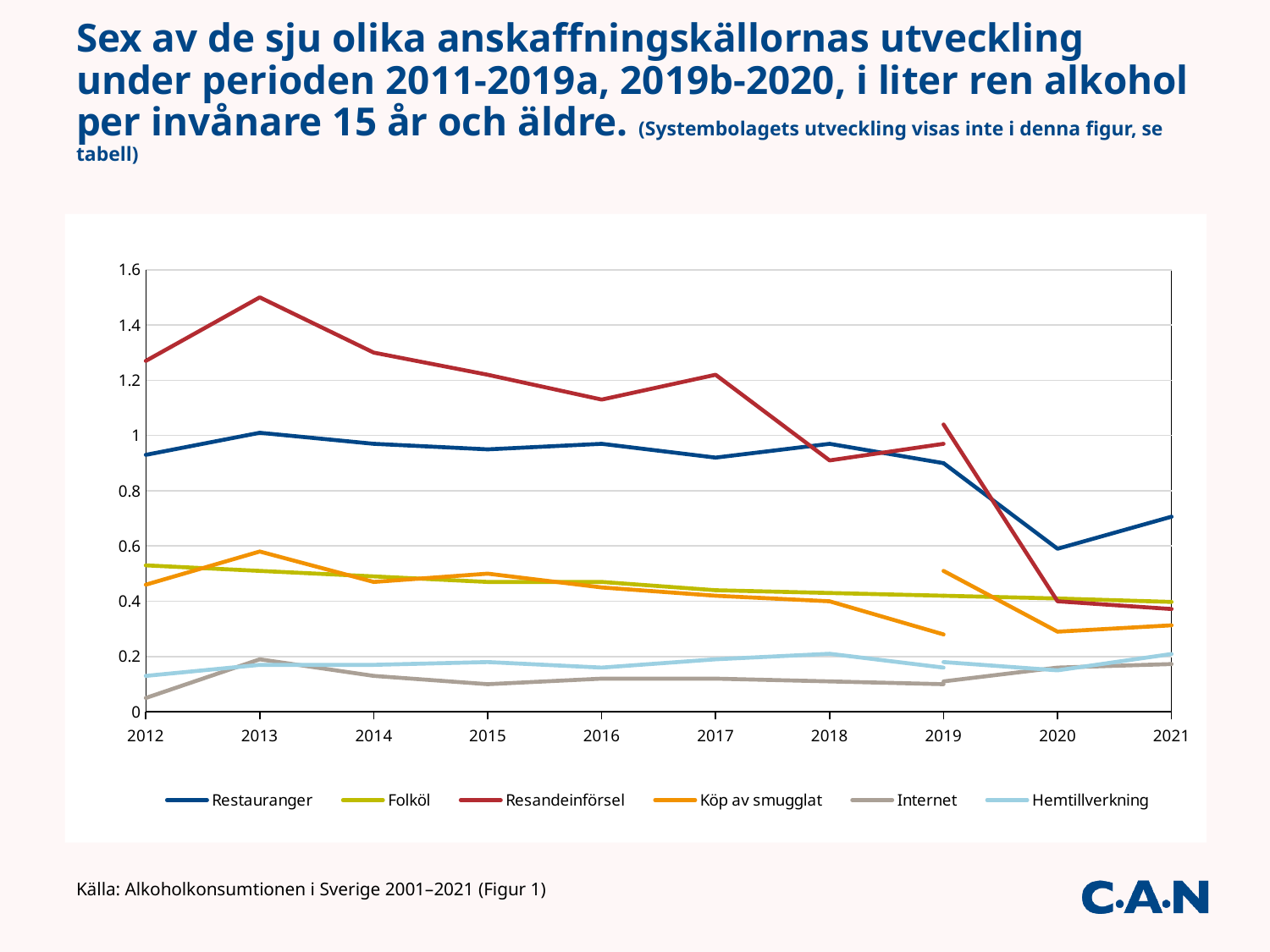
Is the value for Köp av smugglat in 2020 greater or less than 0.4? less Is the value for Internet in 2015 greater or less than 0.2? less What kind of chart is shown on the slide? line chart Which series has the lowest value in 2012? Internet How many years are shown on the x axis? 10 Which series has the highest value in 2013? Resandeinförsel Does the Resandeinförsel line rise or fall from 2013 to 2021? fall In 2021, which is larger: Restauranger or Resandeinförsel? Restauranger Is the value for Restauranger in 2012 greater or less than 0.8? greater How many series does the legend list? 6 In 2012, which is larger: Resandeinförsel or Restauranger? Resandeinförsel